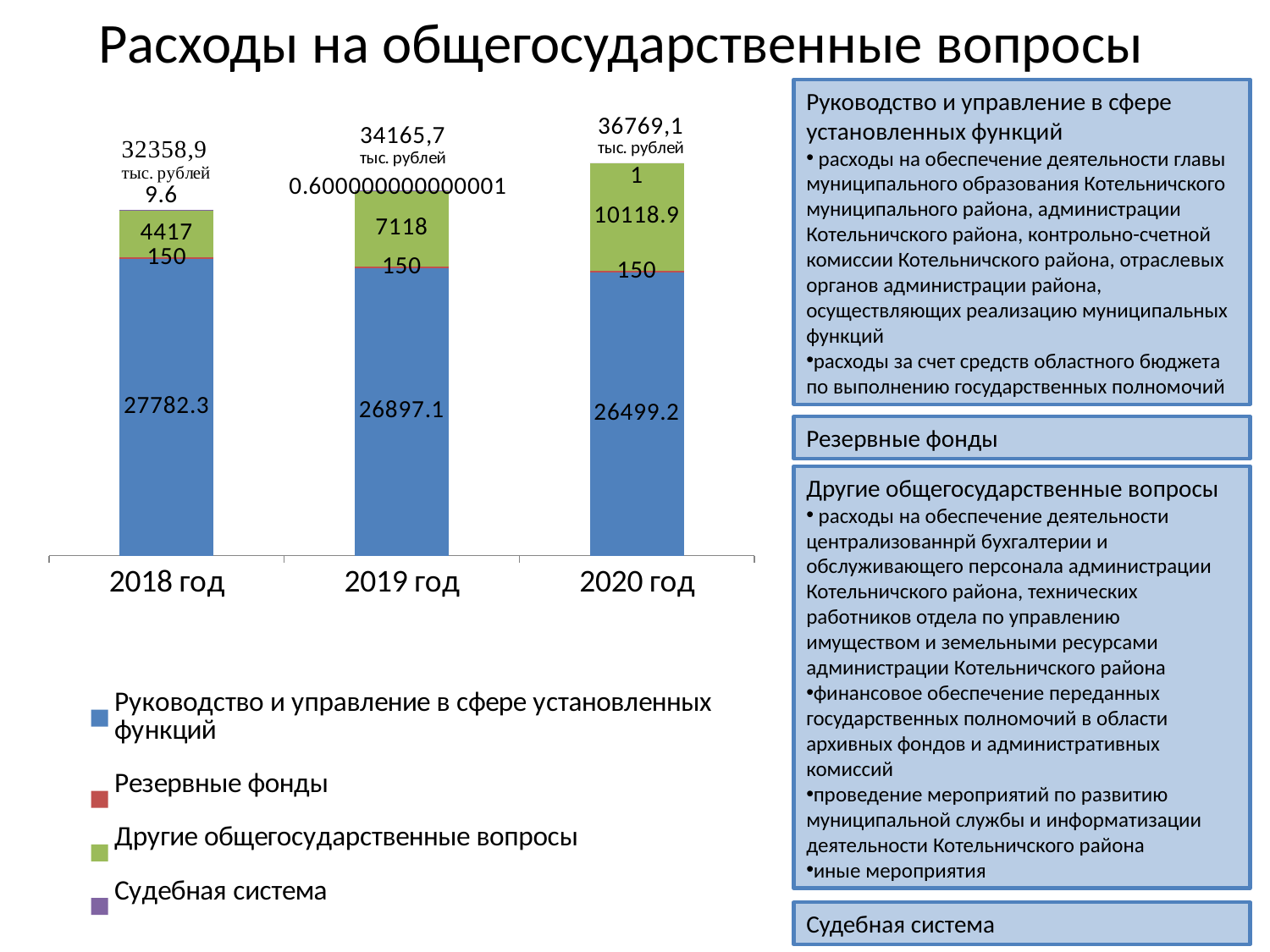
Which is larger: Руководство и управление в сфере установленных функций for 2018 год or for 2019 год? 2018 год Which year has the lowest value for Руководство и управление в сфере установленных функций? 2020 год Which year has the highest value for Другие общегосударственные вопросы? 2020 год What is the value of Резервные фонды for 2019 год? 150 What kind of chart is shown on the slide? stacked bar chart How many categories (years) are shown on the x axis? 3 What is the value of Руководство и управление в сфере установленных функций for 2018 год? 27782.3 What is the difference between the Другие общегосударственные вопросы values for 2019 год and 2018 год? 2701 Do the values for Другие общегосударственные вопросы rise or fall from 2018 год to 2020 год? rise What is the value of Другие общегосударственные вопросы for 2020 год? 10118.9 What is the total shown above the bar for 2020 год? 36769,1 тыс. рублей How many series does the legend list? 4